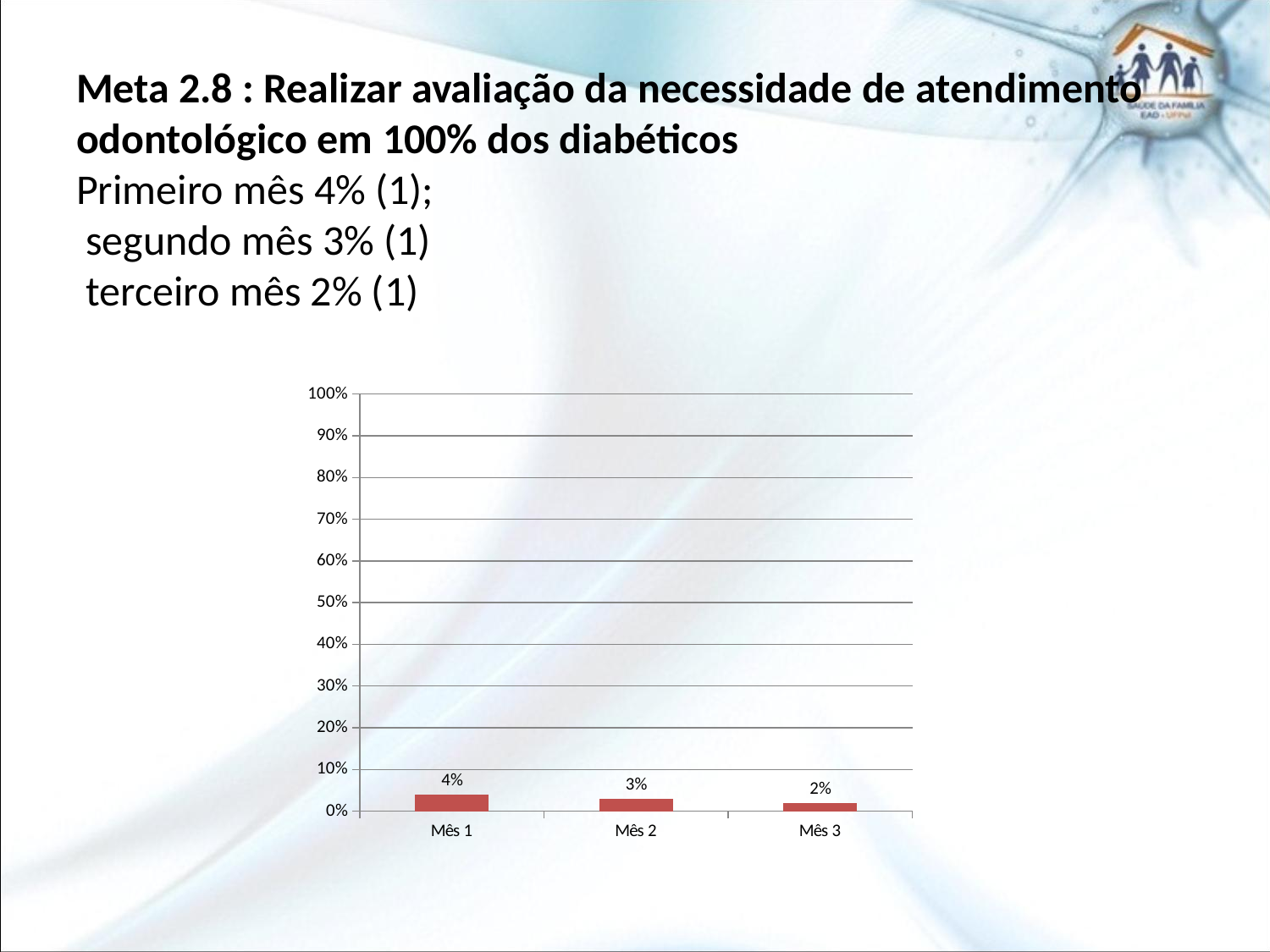
What is the value for Mês 1? 4% What is the value for Mês 3? 2% What is the value for Mês 2? 3% What kind of chart is shown on the slide? bar chart Is the value for Mês 1 greater or less than 10%? less Which month has the lowest value? Mês 3 Which is larger, the value for Mês 2 or the value for Mês 3? Mês 2 What is the maximum value shown on the y axis? 100% Which month has the highest value? Mês 1 How many categories are shown on the x axis? 3 Do the values rise or fall from Mês 1 to Mês 3? fall What is the difference between the values for Mês 1 and Mês 3? 2%